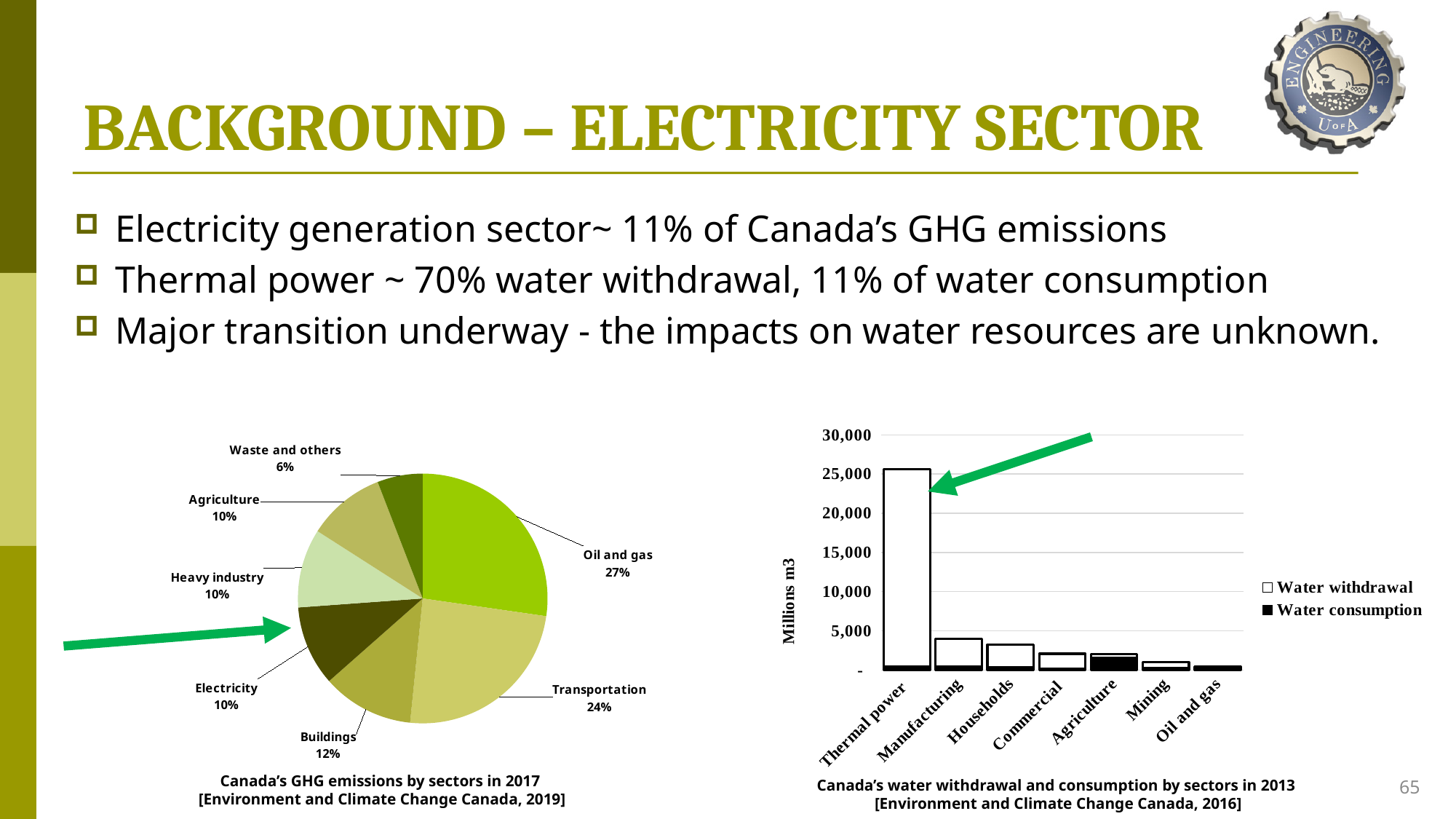
In the bar chart of Canada's water withdrawal and consumption by sectors in 2013, which sector has the highest water withdrawal? Thermal power In the pie chart of Canada's GHG emissions by sectors in 2017, which sector has the largest share? Oil and gas In the pie chart of Canada's GHG emissions by sectors in 2017, what share does Transportation have? 24% In the pie chart of Canada's GHG emissions by sectors in 2017, what share does Oil and gas have? 27% What kind of chart is the chart of Canada's water withdrawal and consumption by sectors in 2013? bar chart In the bar chart of Canada's water withdrawal and consumption by sectors in 2013, is the water withdrawal for Manufacturing greater or less than 5,000? less In the pie chart of Canada's GHG emissions by sectors in 2017, how many sectors are shown? 7 In the bar chart of Canada's water withdrawal and consumption by sectors in 2013, how many series does the legend list? 2 In the pie chart of Canada's GHG emissions by sectors in 2017, what share does Buildings have? 12% In the pie chart of Canada's GHG emissions by sectors in 2017, which sector has the smallest share? Waste and others In the pie chart of Canada's GHG emissions by sectors in 2017, how many percentage points larger is Oil and gas than Transportation? 3%